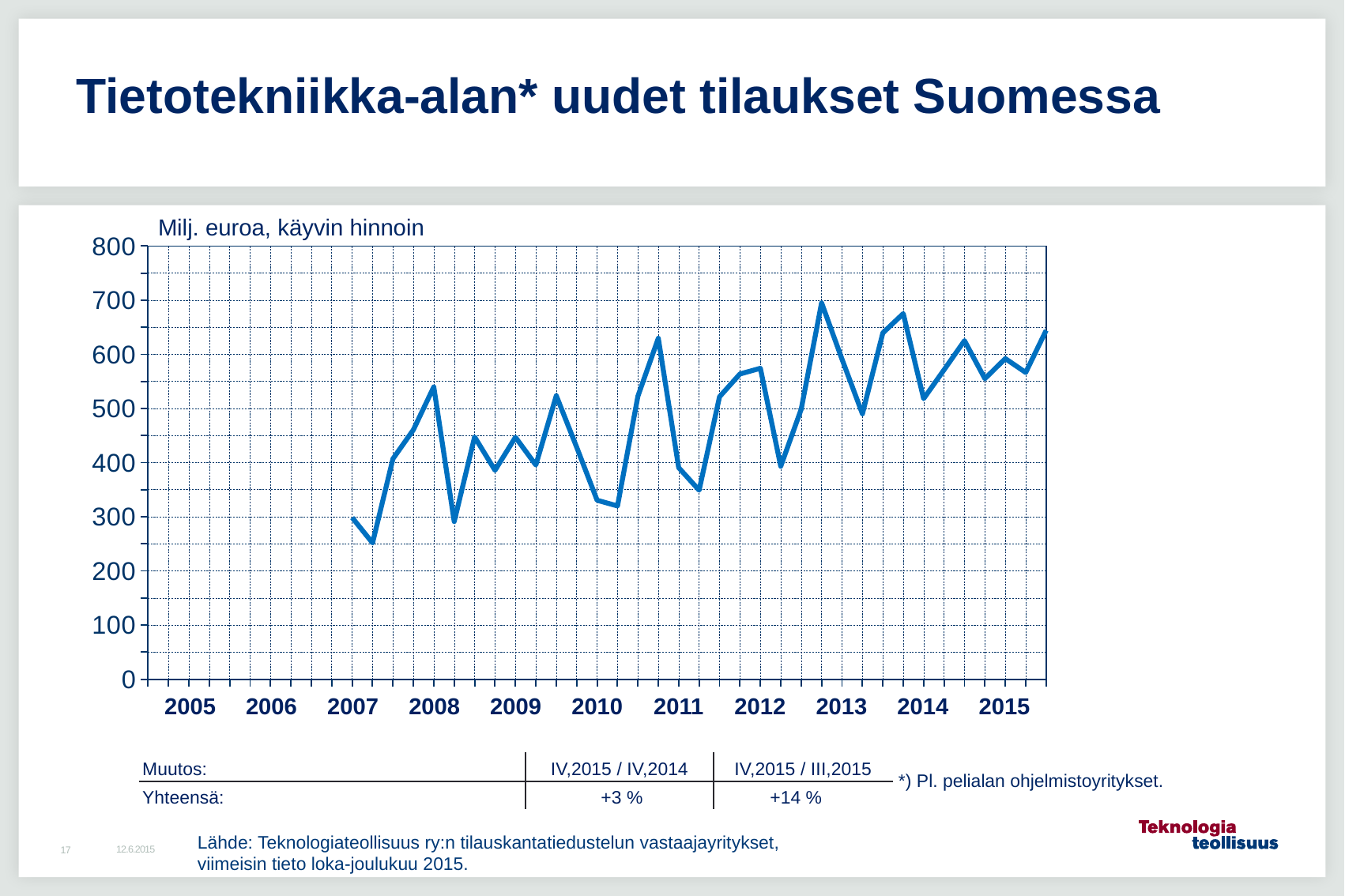
According to the table below the chart, what is the change for IV,2015 / IV,2014? +3 % In which year does the line reach its lowest point? 2007 Which is higher: the value at the start of 2008 or the value at the start of 2007? start of 2008 Is the lowest point of the line, in 2007, greater or less than 300? less What unit label is shown above the y axis of the chart? Milj. euroa, käyvin hinnoin How many year labels are shown on the x axis? 11 Is the highest peak of the line, near 2013, greater or less than 600? greater Is the last plotted value, at the end of 2015, greater or less than 600? greater What is the title of the slide's chart? Tietotekniikka-alan* uudet tilaukset Suomessa Overall, does the line rise or fall from 2007 to 2015? rise What kind of chart is shown on the slide? line chart